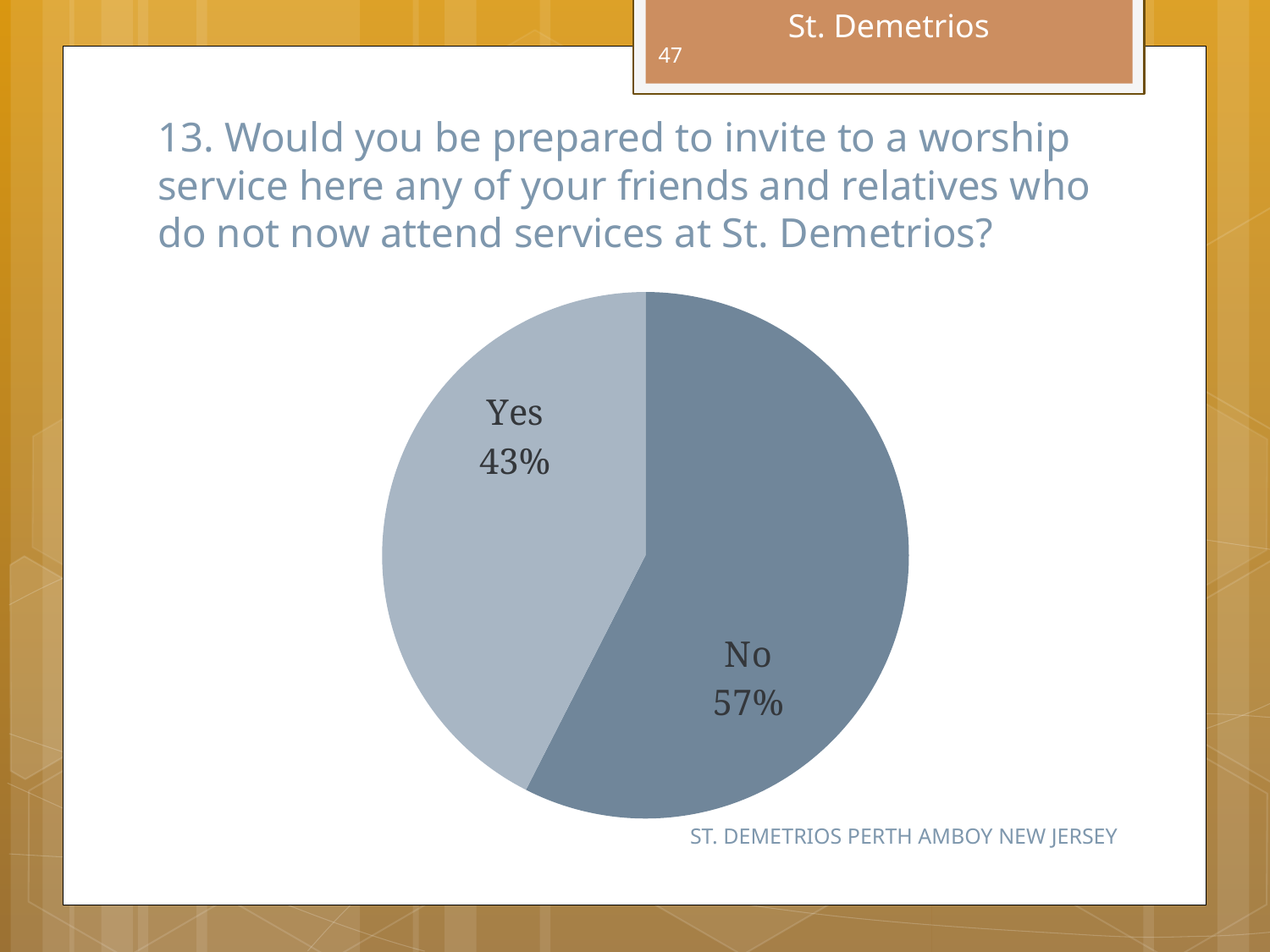
Which is larger, the "Yes" slice or the "No" slice? No What percentage of respondents answered "No"? 57% Which slice is shown in the darker blue-grey colour? No What is the difference in percentage points between the "No" and "Yes" slices? 14 What share of the pie does the "No" slice represent? 57% What percentage of respondents answered "Yes"? 43% Which response has the smallest share of the pie? Yes Is the "Yes" slice greater or less than 50% of the pie? less Which response has the largest share of the pie? No What kind of chart is shown on the slide? pie chart What is the number of the survey question shown above the chart? 13 How many slices does the pie chart have? 2